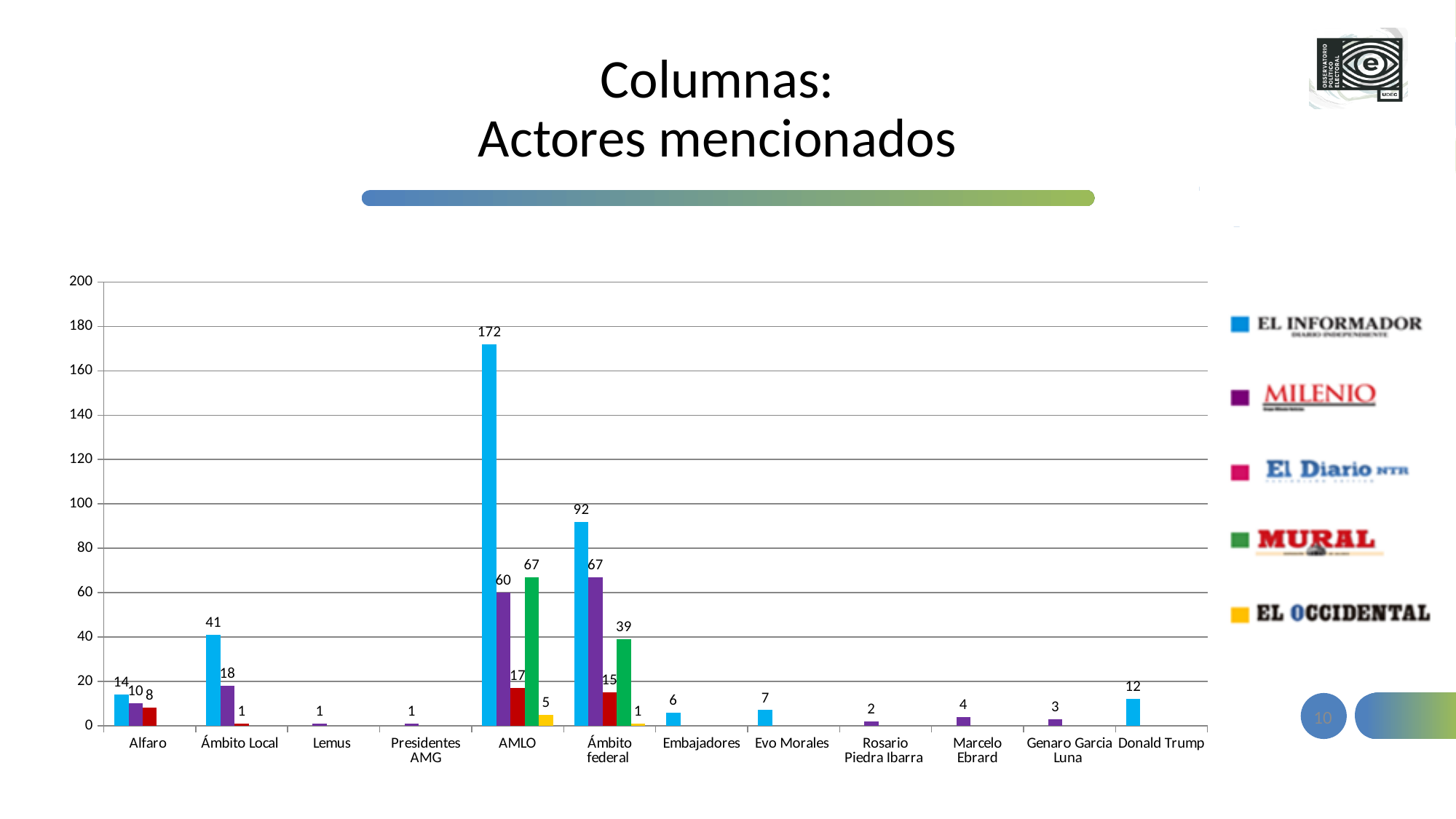
What is the difference between the El Informador values for AMLO and Ámbito federal? 80 Which category has the highest El Informador value? AMLO Is the El Informador value for Ámbito Local greater or less than 40? greater What kind of chart is shown on the slide? Bar chart How many categories are shown on the x axis? 12 What is the Milenio value for Ámbito Local? 18 What is the Mural value for Ámbito federal? 39 What is the El Occidental value for AMLO? 5 Which is larger for AMLO: the Milenio value or the Mural value? Mural What is the El Informador value for AMLO? 172 How many series does the legend list? 5 What is the title of the slide? Columnas: Actores mencionados